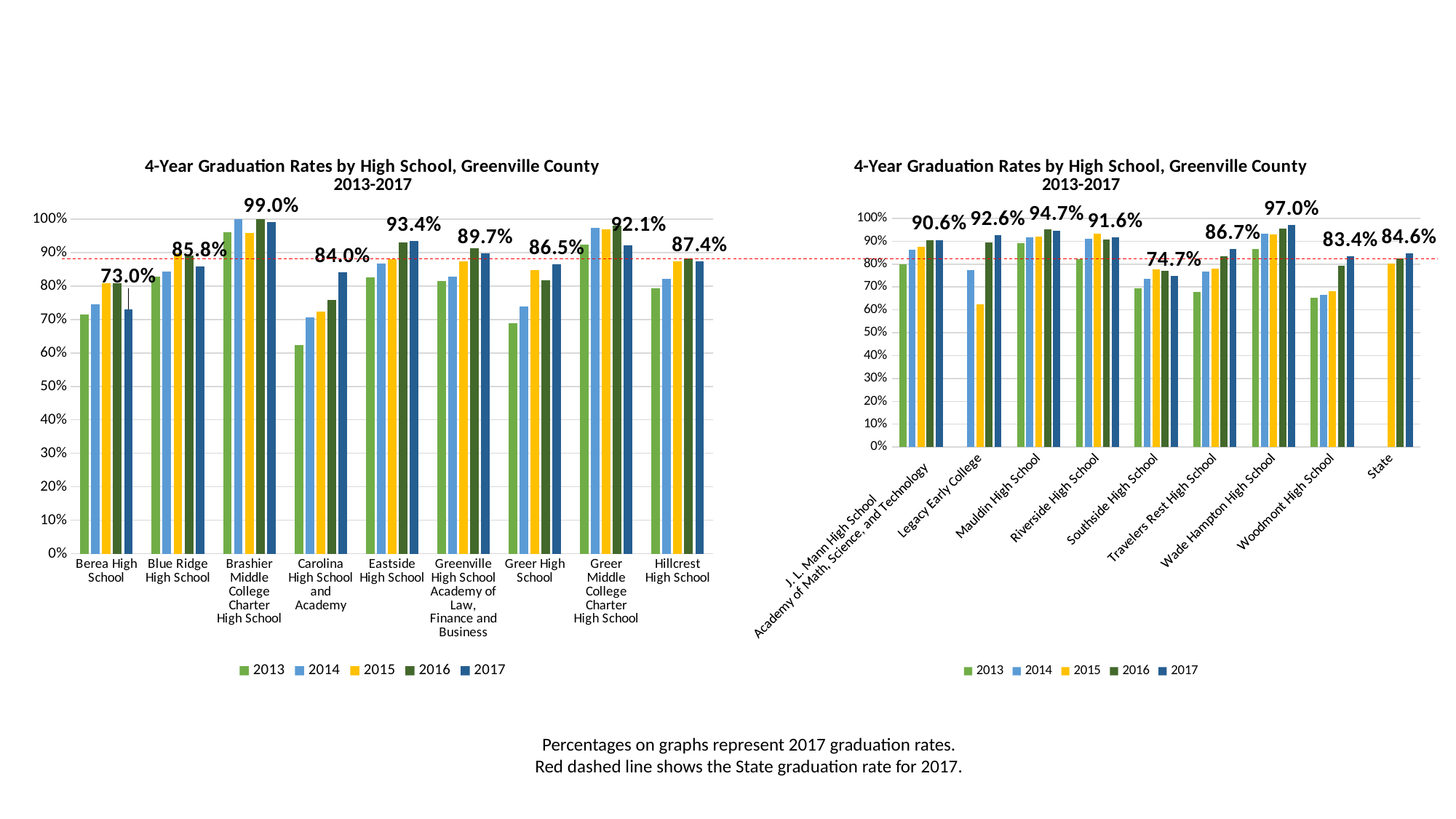
On the left chart, what is the 2017 graduation rate for Berea High School? 73.0% On the left chart, is the 2013 value for Carolina High School and Academy greater or less than 70%? less How many high schools are shown on the left chart? 9 On the right chart, what is the 2017 graduation rate for the State? 84.6% What kind of chart is the left chart? bar chart How many series does the legend of the right chart list? 5 On the right chart, which has the higher 2017 graduation rate, Mauldin High School or Riverside High School? Mauldin High School On the left chart, which high school has the highest 2017 graduation rate? Brashier Middle College Charter High School On the right chart, is the 2015 value for Legacy Early College greater or less than 70%? less On the right chart, what is the 2017 graduation rate for Wade Hampton High School? 97.0% On the left chart, what is the difference between the 2017 graduation rates of Eastside High School and Carolina High School and Academy? 9.4% On the right chart, which category has the lowest 2017 graduation rate? Southside High School